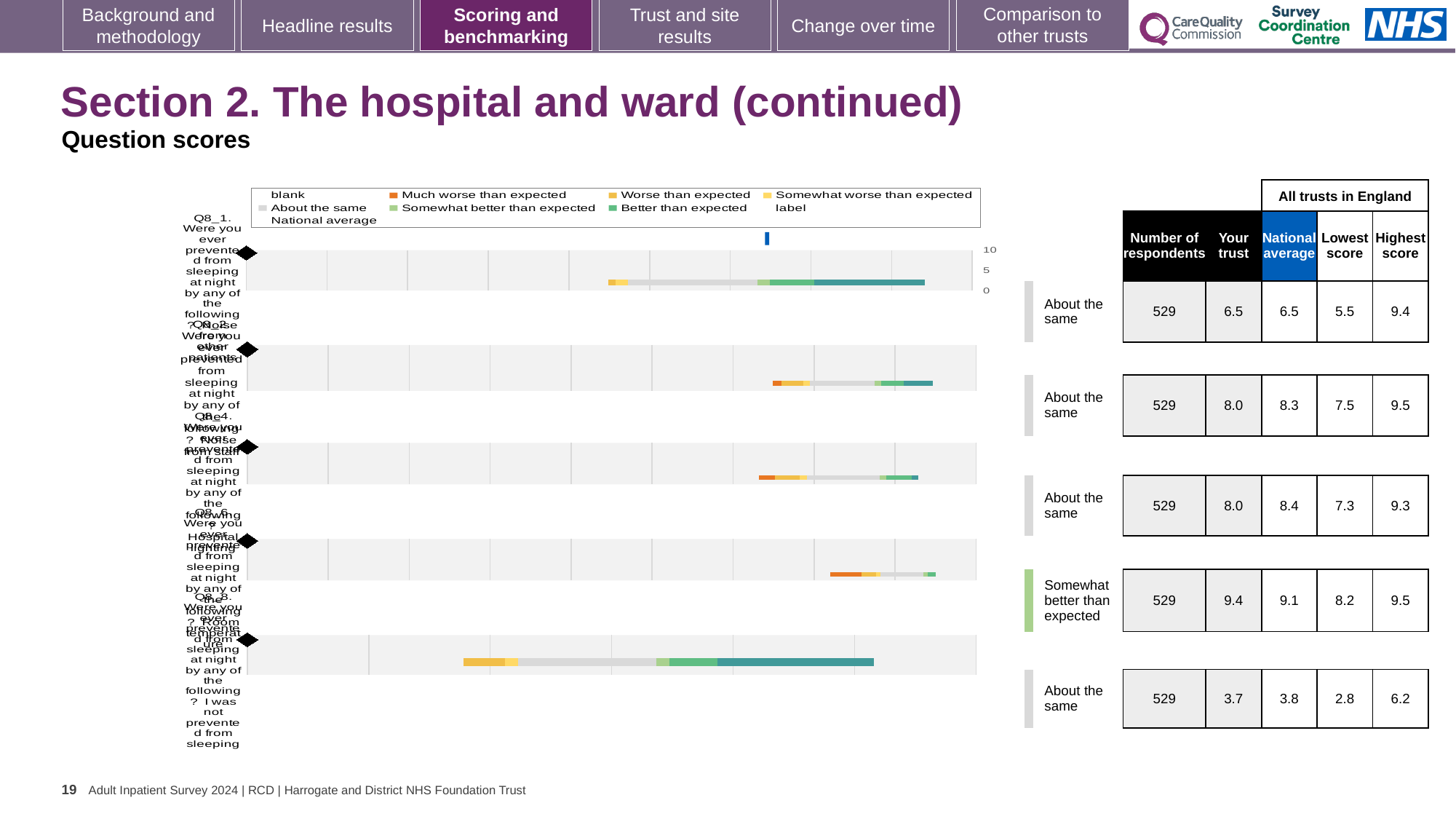
For the fourth row, is the 'Your trust' score (9.4) larger or smaller than the national average (9.1)? larger What is the 'Your trust' score for the first row (Q8_1) in the table beside the chart? 6.5 How many respondents are listed for each row in the table beside the chart? 529 In the chart legend, which colour represents 'Better than expected'? teal What is the difference between the highest score (9.4) and the lowest score (5.5) for the first row? 3.9 Which row has the highest 'Your trust' score in the table beside the chart? the fourth row (9.4) How many question rows (bars) are plotted in the chart? 5 Which row has the lowest 'Your trust' score in the table beside the chart? the fifth row (3.7) What is the national average for the first row (Q8_1) in the table beside the chart? 6.5 Which row is rated 'Somewhat better than expected' rather than 'About the same'? the fourth row In the chart legend, which colour represents 'Much worse than expected'? orange What kind of chart is shown on the slide? bar chart